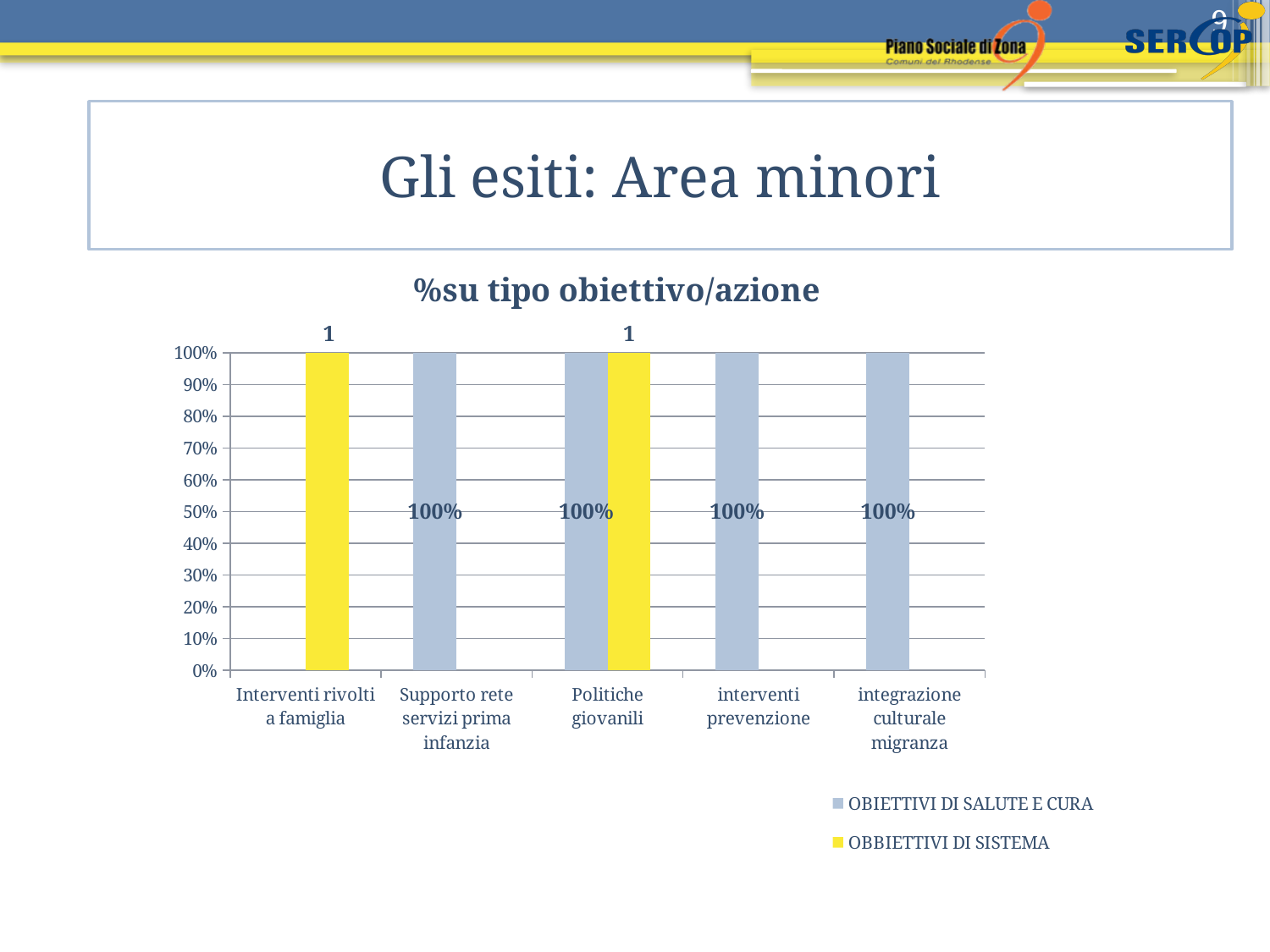
How many categories are shown on the x axis of the chart? 5 What data label is shown on the OBBIETTIVI DI SISTEMA bar for Politiche giovanili? 1 What is the value of OBIETTIVI DI SALUTE E CURA for Supporto rete servizi prima infanzia? 100% What is the value of OBIETTIVI DI SALUTE E CURA for integrazione culturale migranza? 100% What is the title of the chart? %su tipo obiettivo/azione What is the value of OBIETTIVI DI SALUTE E CURA for interventi prevenzione? 100% What kind of chart is shown on the slide? bar chart How many series does the chart legend list? 2 What data label is shown on the OBBIETTIVI DI SISTEMA bar for Interventi rivolti a famiglia? 1 Which legend entry is shown in yellow? OBBIETTIVI DI SISTEMA Is the value of OBBIETTIVI DI SISTEMA for Interventi rivolti a famiglia greater or less than 50%? greater What is the value of OBIETTIVI DI SALUTE E CURA for Politiche giovanili? 100%